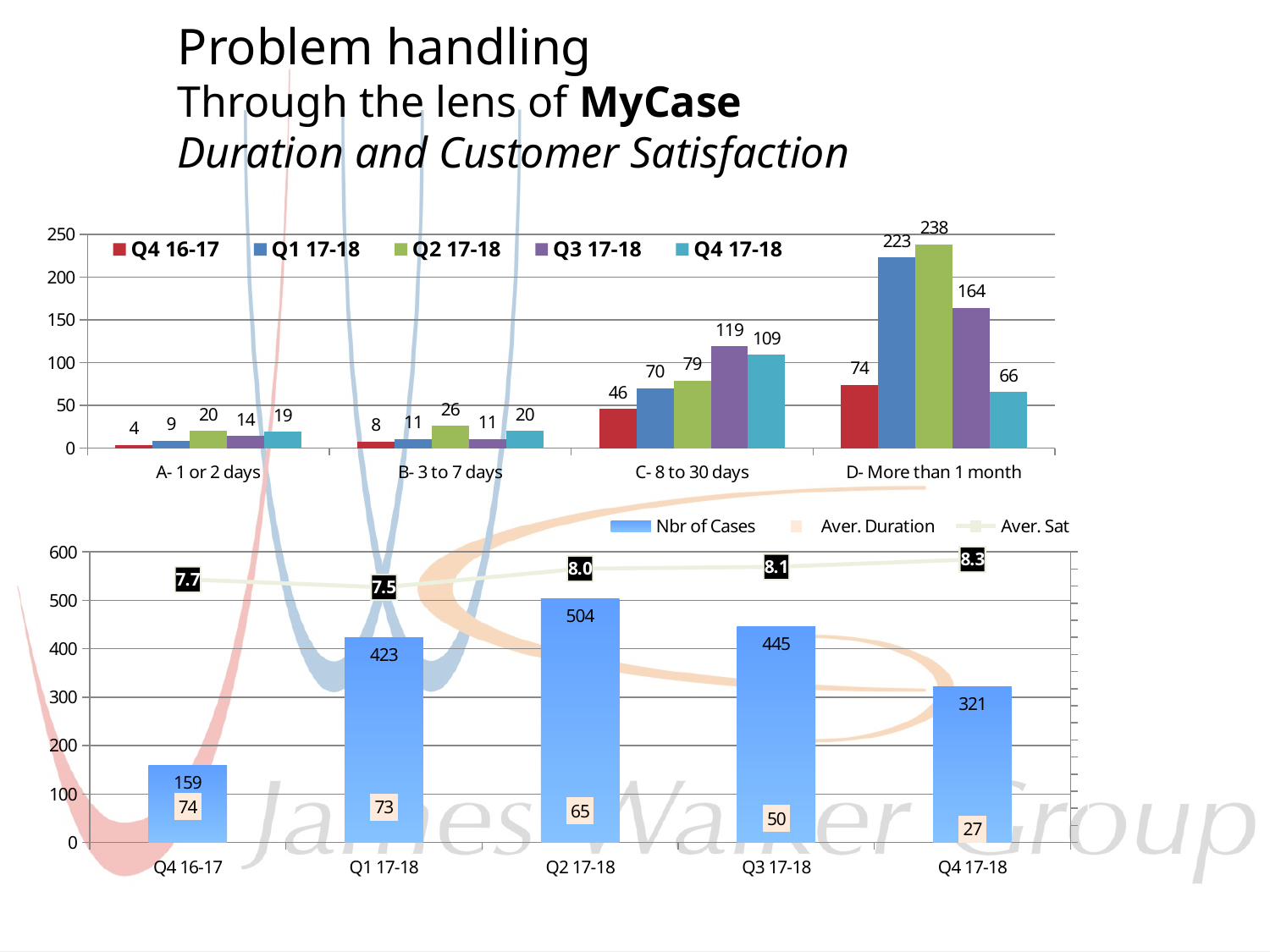
How many categories are shown on the x axis of the top chart? 4 In the top chart, which series has the highest value in the 'D- More than 1 month' category? Q2 17-18 In the top chart, which series has the lowest value in the 'A- 1 or 2 days' category? Q4 16-17 In the bottom chart, does the average duration rise or fall from Q4 16-17 to Q4 17-18? fall In the bottom chart, what is the number of cases for Q2 17-18? 504 In the bottom chart, what is the average duration for Q4 17-18? 27 In the top chart, what is the difference between the Q1 17-18 and Q4 17-18 values in the 'D- More than 1 month' category? 157 How many series does the legend of the top chart list? 5 In the bottom chart, which quarter has the highest average satisfaction? Q4 17-18 In the bottom chart, is the number of cases for Q1 17-18 or Q3 17-18 larger? Q3 17-18 In the top chart, what is the value for Q3 17-18 in the 'C- 8 to 30 days' category? 119 In the top chart, what is the value for Q2 17-18 in the 'D- More than 1 month' category? 238